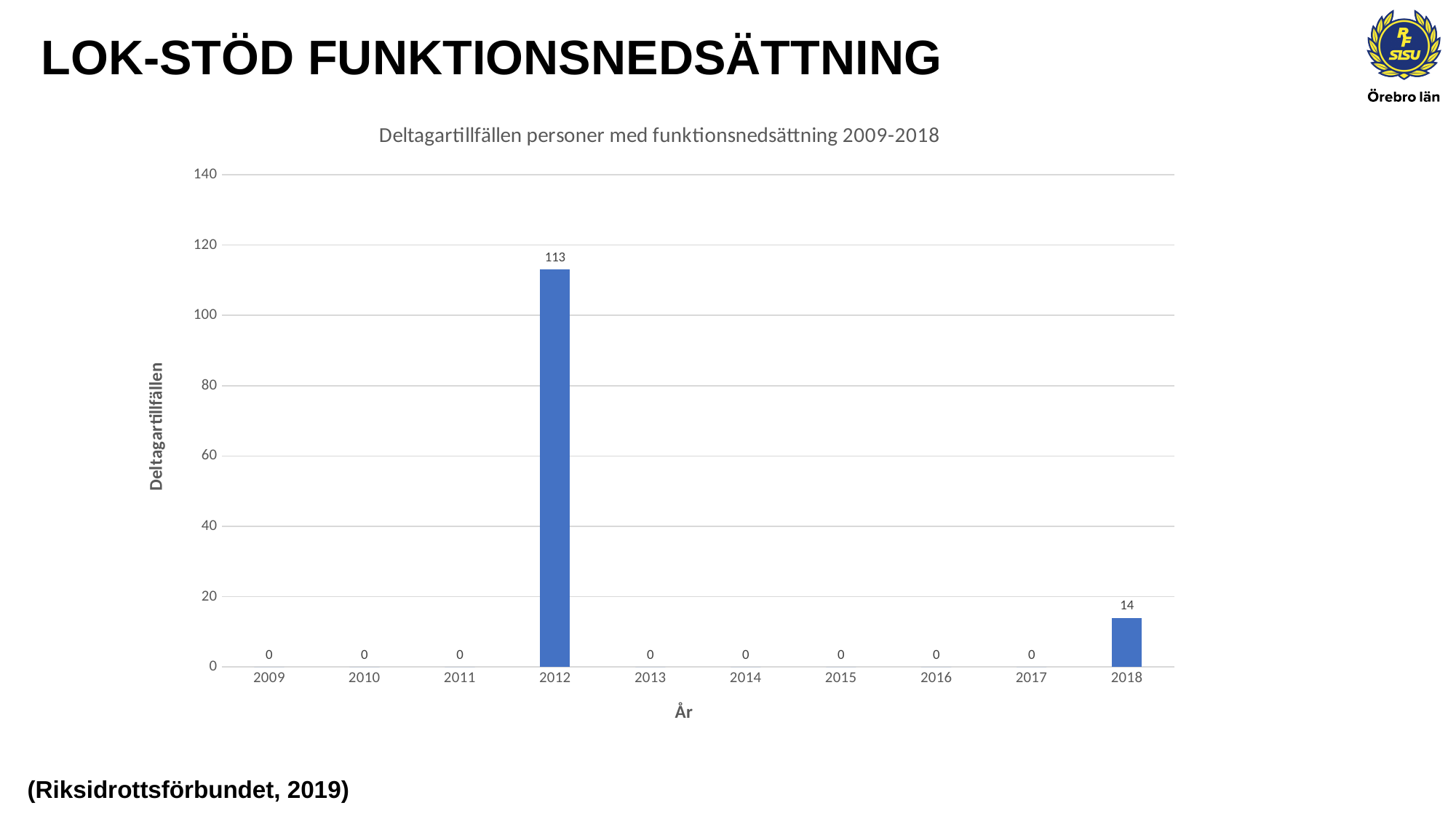
Which is larger, the value for 2012 or the value for 2018? 2012 Is the value for 2012 greater or less than 100? greater Is the value for 2018 greater or less than 20? less How many years are shown on the x axis? 10 What is the value for 2018? 14 What is the title of the chart? Deltagartillfällen personer med funktionsnedsättning 2009-2018 What kind of chart is shown? Bar chart What is the value for 2015? 0 Which year has the highest value? 2012 What is the value for 2012? 113 How many years have a value of 0? 8 What is the difference between the values for 2012 and 2018? 99